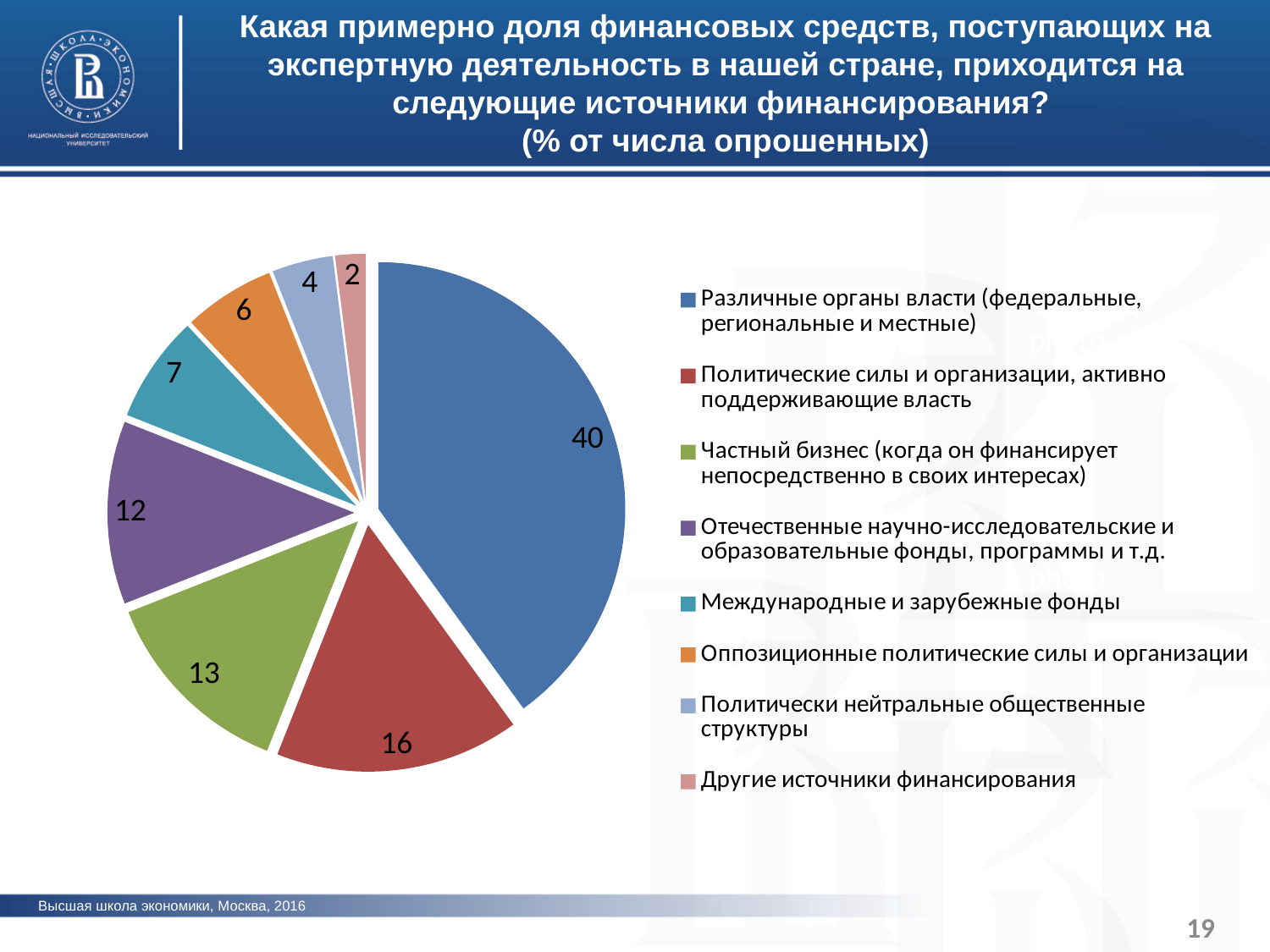
How many entries does the legend list? 8 What is the value for "Различные органы власти (федеральные, региональные и местные)"? 40 What is the value for "Другие источники финансирования"? 2 Which category has the largest slice of the pie? Различные органы власти (федеральные, региональные и местные) What is the value for "Политические силы и организации, активно поддерживающие власть"? 16 What kind of chart is shown on the slide? pie chart How many slices does the pie chart have? 8 What is the difference between the values for "Отечественные научно-исследовательские и образовательные фонды, программы и т.д." and "Оппозиционные политические силы и организации"? 6 Which category has the smallest slice of the pie? Другие источники финансирования What is the value for "Международные и зарубежные фонды"? 7 What is the value for "Частный бизнес (когда он финансирует непосредственно в своих интересах)"? 13 Which is larger: the value for "Политически нейтральные общественные структуры" or the value for "Международные и зарубежные фонды"? Международные и зарубежные фонды